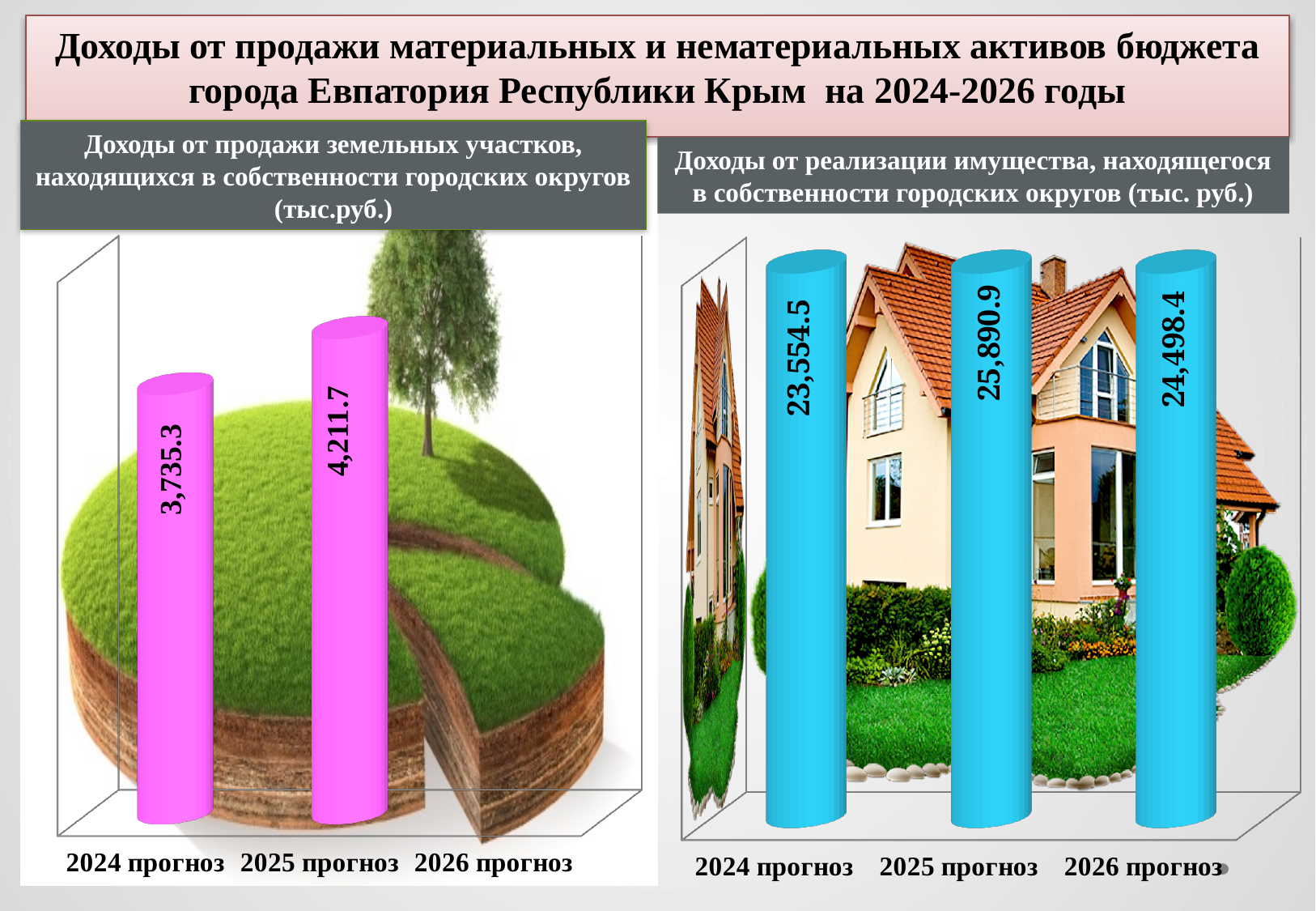
In the right chart (Доходы от реализации имущества), what is the value for 2026 прогноз? 24,498.4 In the right chart (Доходы от реализации имущества), what is the value for 2025 прогноз? 25,890.9 How many bars are plotted in the right chart (Доходы от реализации имущества)? 3 What type of chart is the right chart (Доходы от реализации имущества)? Bar chart In the right chart (Доходы от реализации имущества), which year has the highest value? 2025 прогноз In the left chart (Доходы от продажи земельных участков), what is the value for 2025 прогноз? 4,211.7 In the right chart (Доходы от реализации имущества), which year has the lowest value? 2024 прогноз In the left chart (Доходы от продажи земельных участков), what is the value for 2024 прогноз? 3,735.3 In the left chart (Доходы от продажи земельных участков), what is the difference between the 2025 прогноз and 2024 прогноз values? 476.4 In the right chart (Доходы от реализации имущества), what is the difference between the 2025 прогноз and 2026 прогноз values? 1,392.5 In the left chart (Доходы от продажи земельных участков), which is larger: the value for 2024 прогноз or 2025 прогноз? 2025 прогноз In the right chart (Доходы от реализации имущества), what is the value for 2024 прогноз? 23,554.5